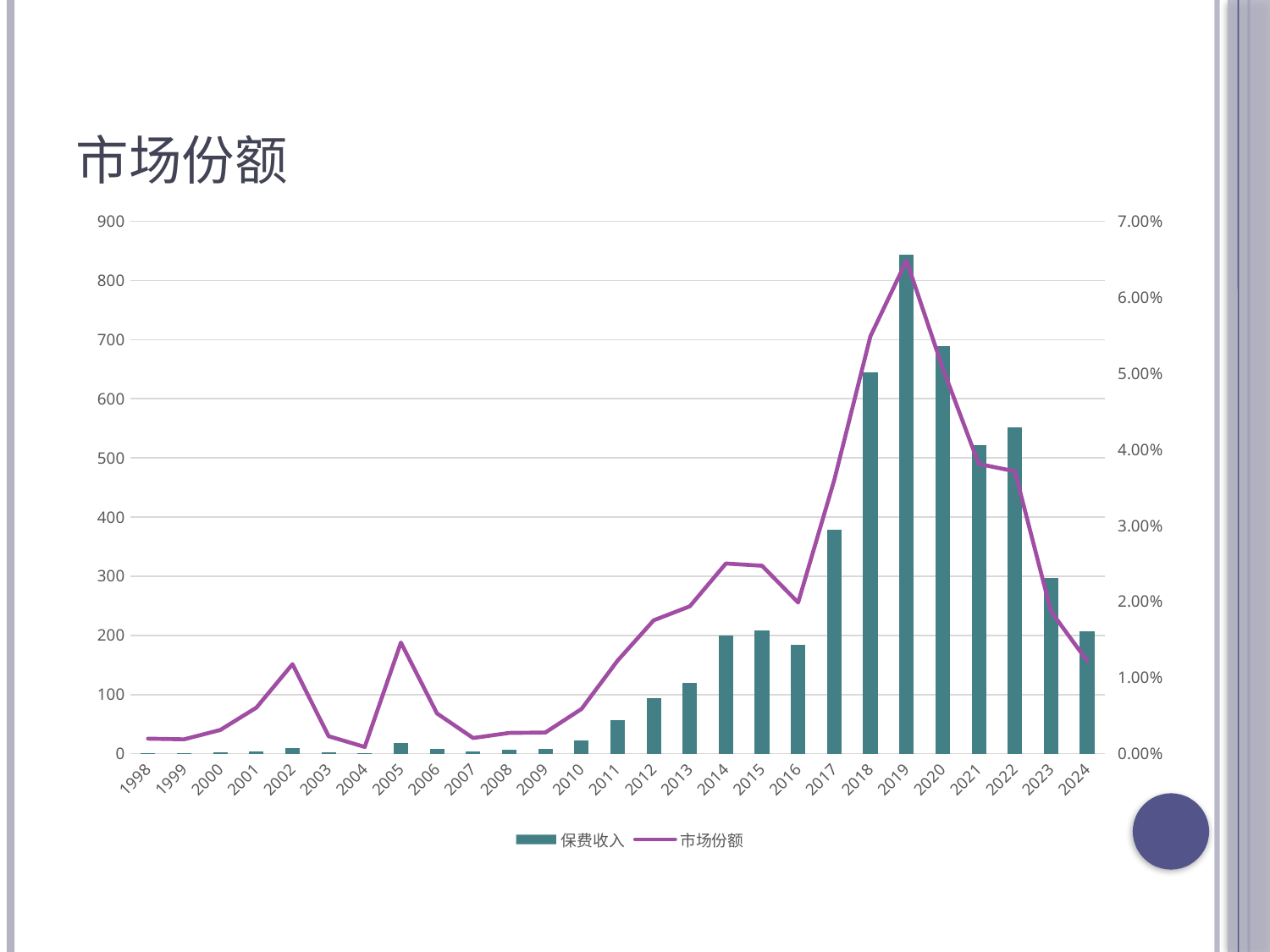
Which year has the larger 保费收入 bar, 2018 or 2020? 2020 Is the 市场份额 value for 2021 greater or less than 4.00%? less What kind of chart is shown on the slide? A combination bar and line chart Is the 保费收入 value for 2017 greater or less than 400? less How many series does the legend list? 2 How many years are shown on the x axis? 27 What is the title of the chart? 市场份额 In which year does the 市场份额 line reach its peak? 2019 Do the 保费收入 bars rise or fall from 2019 to 2024? fall Is the 保费收入 value for 2019 greater or less than 800? greater Which year has the highest 保费收入 bar? 2019